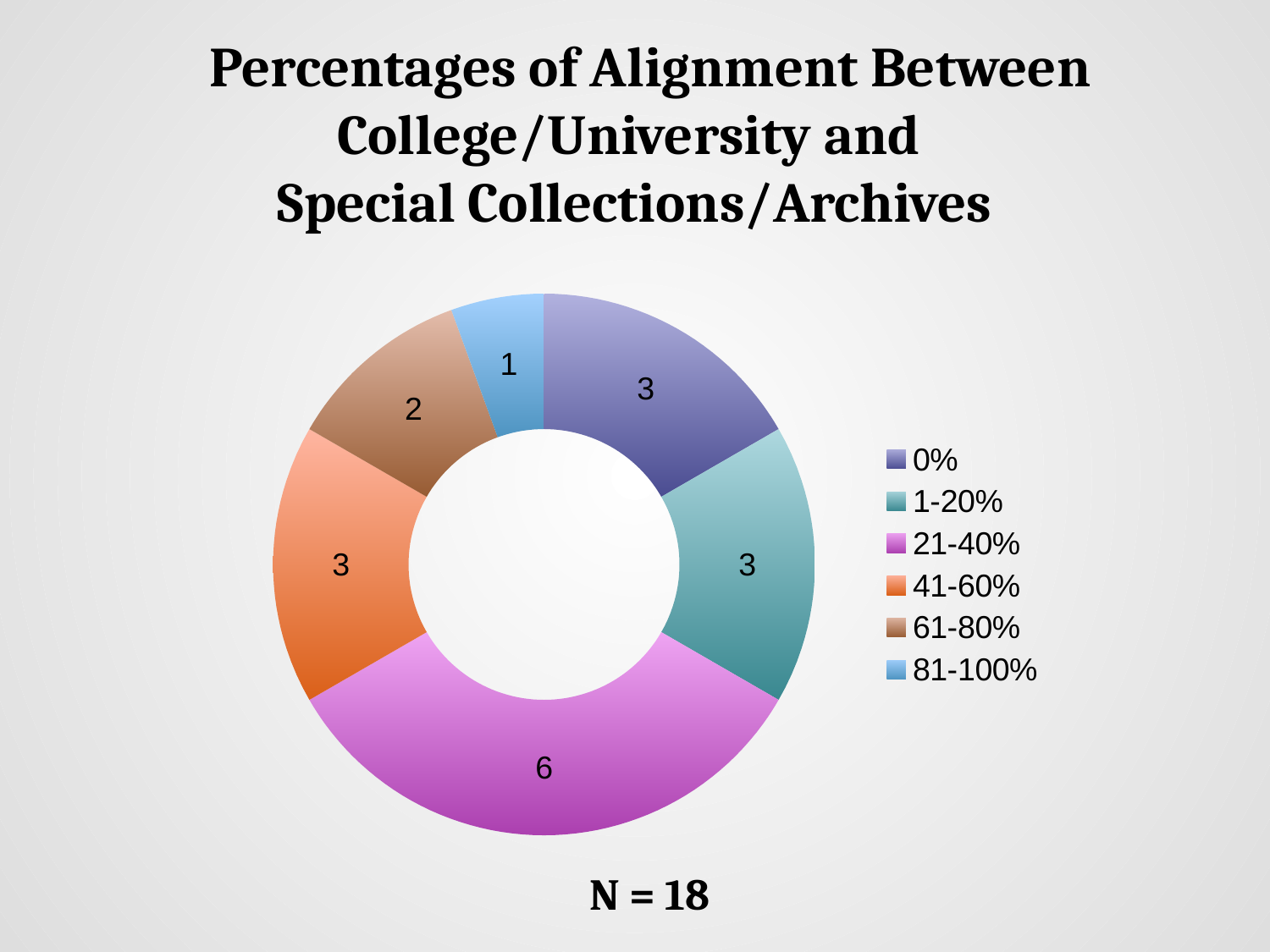
How many categories does the chart show? 6 What value is shown for the 21-40% category? 6 What kind of chart is shown on the slide? Doughnut (pie) chart What value is shown for the 0% category? 3 What fraction of the total does the 21-40% slice represent? One third (6 of 18) Which is larger, the value for 41-60% or the value for 61-80%? 41-60% What is the difference between the values for 21-40% and 61-80%? 4 Which category has the largest slice? 21-40% What value is shown for the 61-80% category? 2 What value is shown for the 81-100% category? 1 What is the total N stated below the chart? N = 18 Which category has the smallest slice? 81-100%